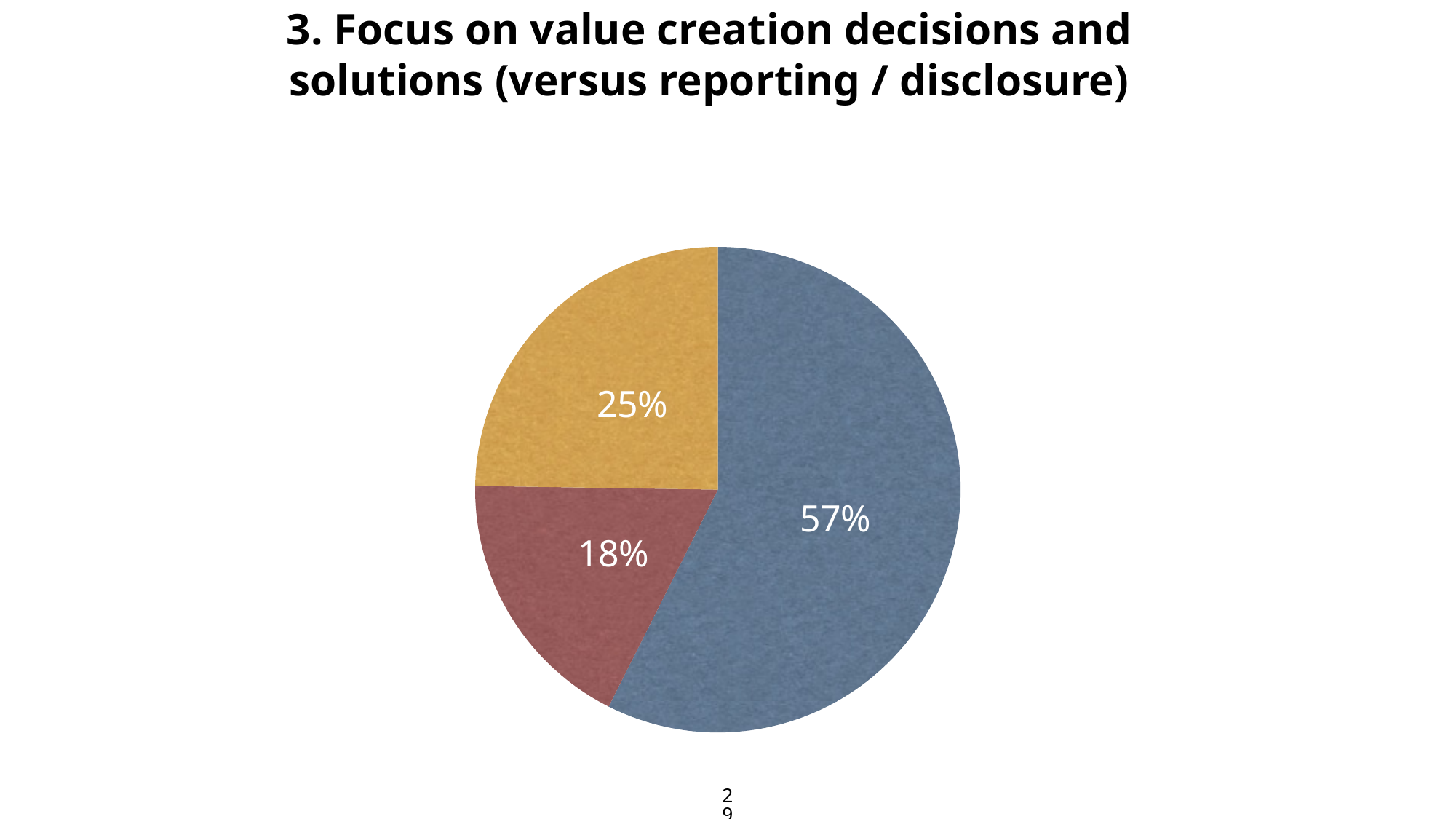
What is the title of the chart on the slide? 3. Focus on value creation decisions and solutions (versus reporting / disclosure) Which colour slice is the smallest in the pie chart? red What is the difference in percentage points between the blue slice and the orange slice? 32 Is the blue slice more or less than half of the pie? more What percentage is shown on the orange slice of the pie chart? 25% What percentage is shown on the blue slice of the pie chart? 57% What is the difference in percentage points between the orange slice and the red slice? 7 What kind of chart is shown on the slide? pie chart Which colour slice is the largest in the pie chart? blue Which is larger in the pie chart, the orange slice or the red slice? orange What percentage is shown on the red slice of the pie chart? 18% How many slices does the pie chart have? 3